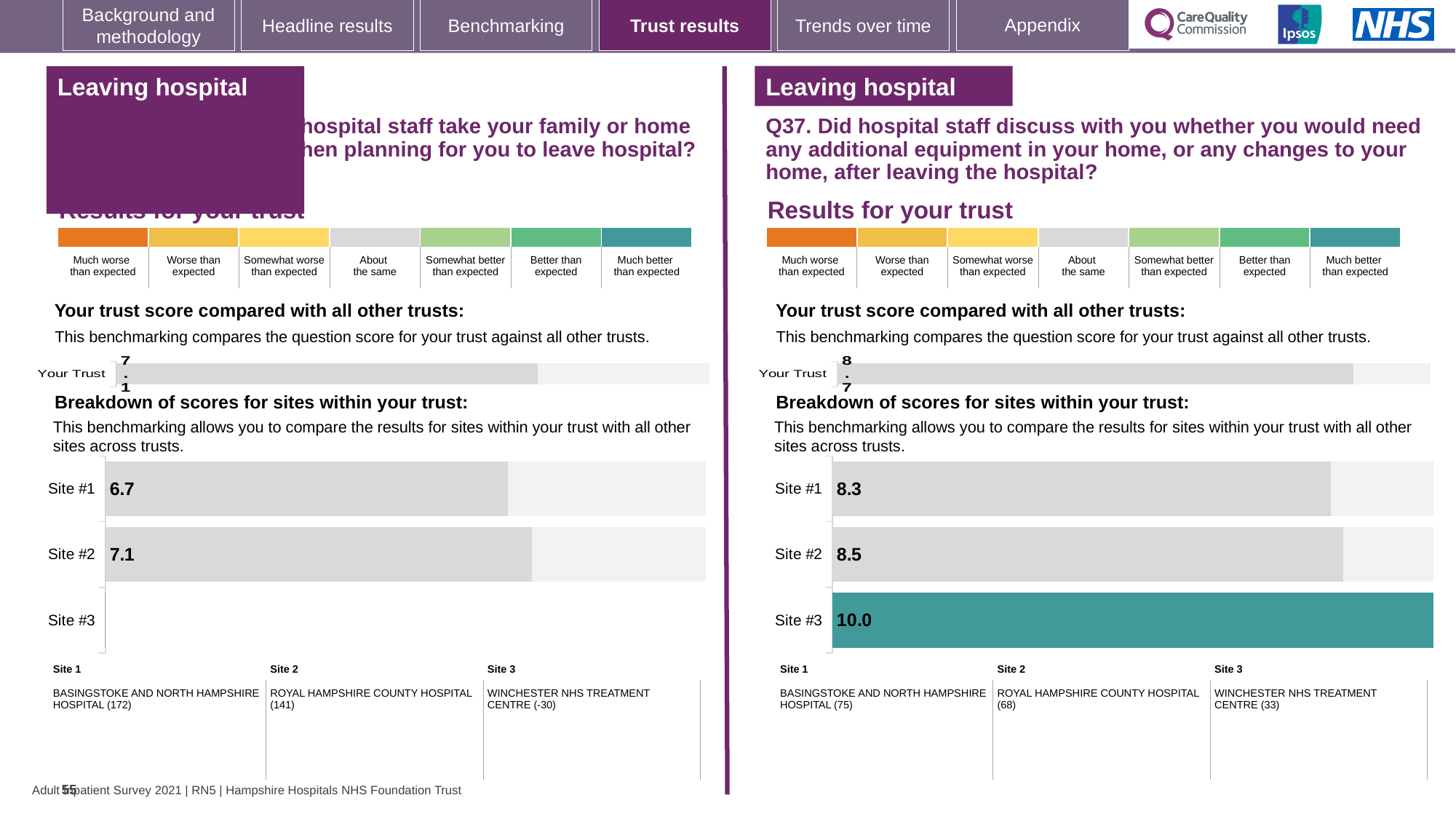
On the right-hand (Q37) site breakdown chart, which site has the lowest score? Site #1 On the right-hand (Q37) site breakdown chart, what is the difference between the scores for Site #3 and Site #1? 1.7 On the left-hand site breakdown chart, what is the score for Site #1? 6.7 On the left-hand site breakdown chart, what is the score for Site #2? 7.1 On the left-hand 'Your trust score compared with all other trusts' chart, what is the score for Your Trust? 7.1 On the right-hand (Q37) 'Your trust score compared with all other trusts' chart, what is the score for Your Trust? 8.7 What kind of chart is used for the site breakdown of scores on the right-hand (Q37) side? Bar chart On the right-hand (Q37) site breakdown chart, what is the score for Site #3? 10.0 On the left-hand site breakdown chart, which has the larger score, Site #1 or Site #2? Site #2 On the right-hand (Q37) site breakdown chart, which site's bar is coloured teal rather than grey? Site #3 On the right-hand (Q37) site breakdown chart, what is the score for Site #1? 8.3 On the right-hand (Q37) site breakdown chart, which site has the highest score? Site #3